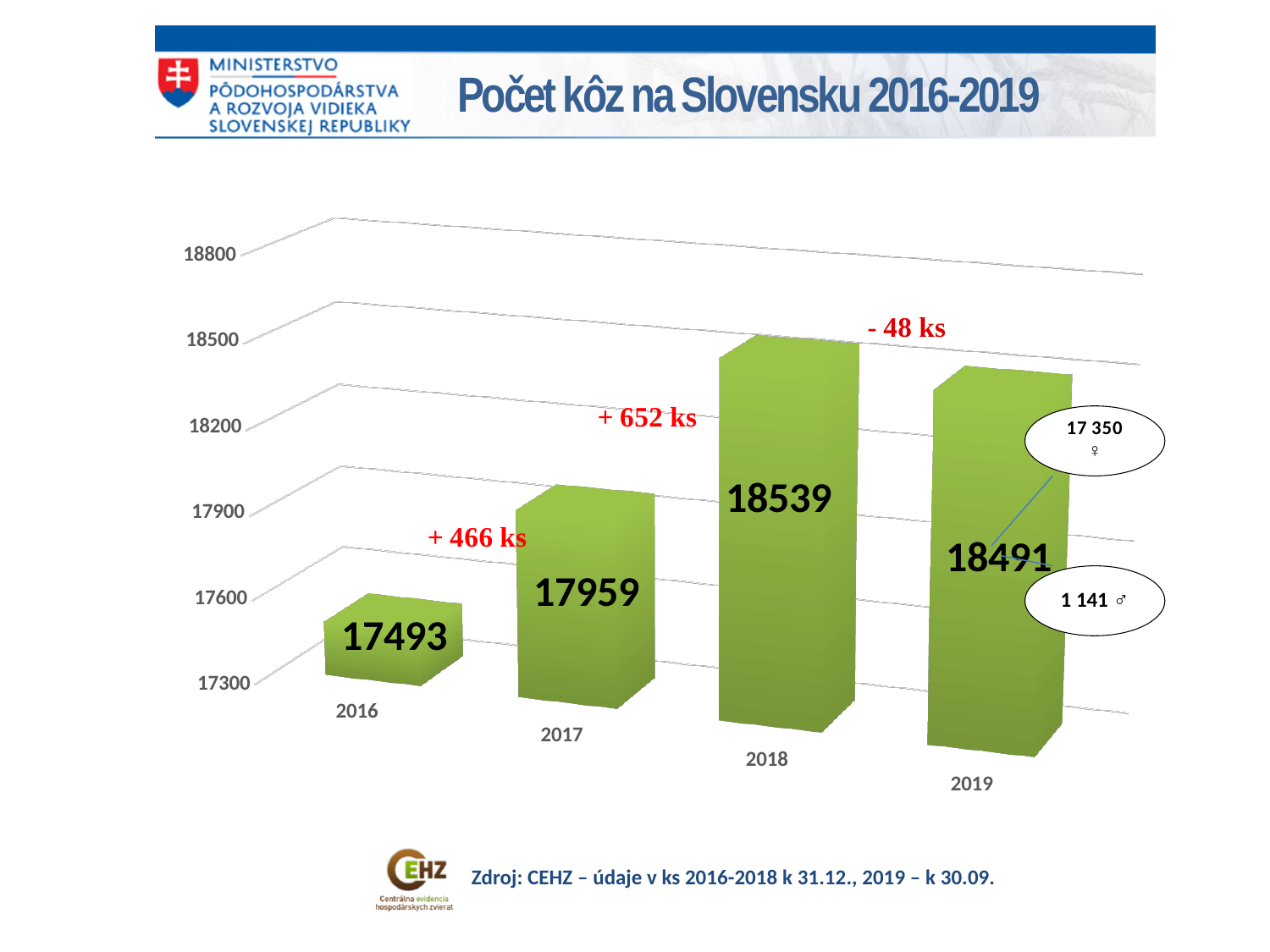
What kind of chart is shown on the slide? bar chart What is the number of goats in Slovakia in 2016? 17493 Which year has the highest number of goats? 2018 What is the title of the chart? Počet kôz na Slovensku 2016-2019 What is the difference between the number of goats in 2017 and 2016? 466 What is the number of goats in Slovakia in 2018? 18539 What is the difference between the number of goats in 2018 and 2019? 48 Is the value for 2017 greater or less than 18200? less How many years are shown on the chart? 4 Which year has the lowest number of goats? 2016 What is the number of goats in Slovakia in 2019? 18491 Which year has more goats, 2017 or 2019? 2019